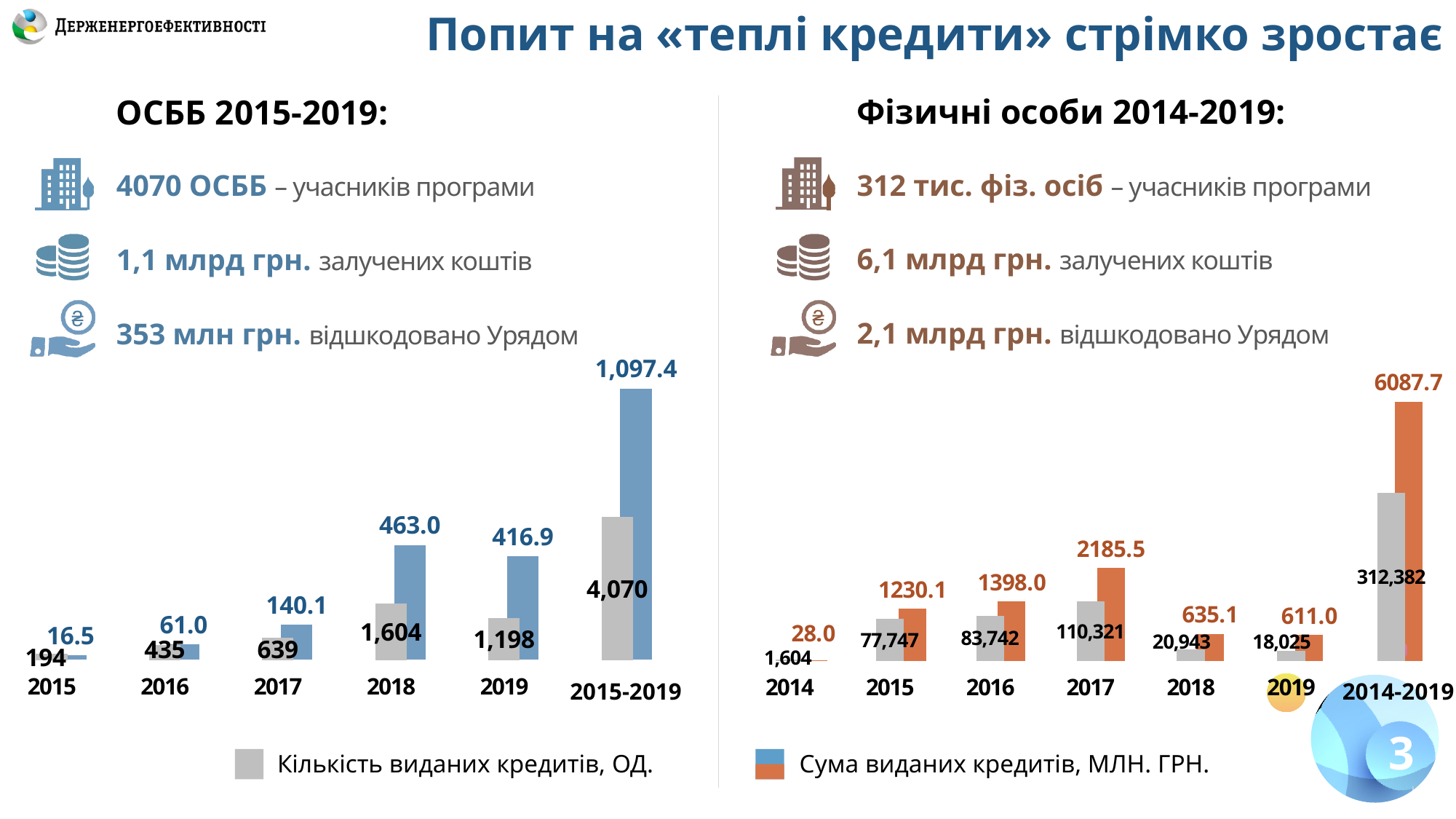
In the right chart (Фізичні особи 2014-2019), what is the difference between the number of loans issued in 2017 and in 2016? 26,579 How many categories are shown on the x axis of the right chart (Фізичні особи 2014-2019)? 7 How many series does the legend at the bottom of the slide list? 2 In the left chart (ОСББ 2015-2019), which single year has the highest sum of loans issued? 2018 In the right chart (Фізичні особи 2014-2019), how many loans were issued in 2016? 83,742 In the right chart (Фізичні особи 2014-2019), which single year has the lowest sum of loans issued? 2014 In the left chart (ОСББ 2015-2019), how many loans were issued (Кількість виданих кредитів) in 2019? 1,198 In the left chart (ОСББ 2015-2019), what is the sum of loans issued (Сума виданих кредитів) in 2018? 463.0 In the right chart (Фізичні особи 2014-2019), which year had more loans issued, 2018 or 2019? 2018 In the right chart (Фізичні особи 2014-2019), what is the sum of loans issued in 2017? 2185.5 What type of chart is the left chart (ОСББ 2015-2019)? Bar chart In the left chart (ОСББ 2015-2019), what is the difference between the sum of loans issued in 2018 and in 2019? 46.1